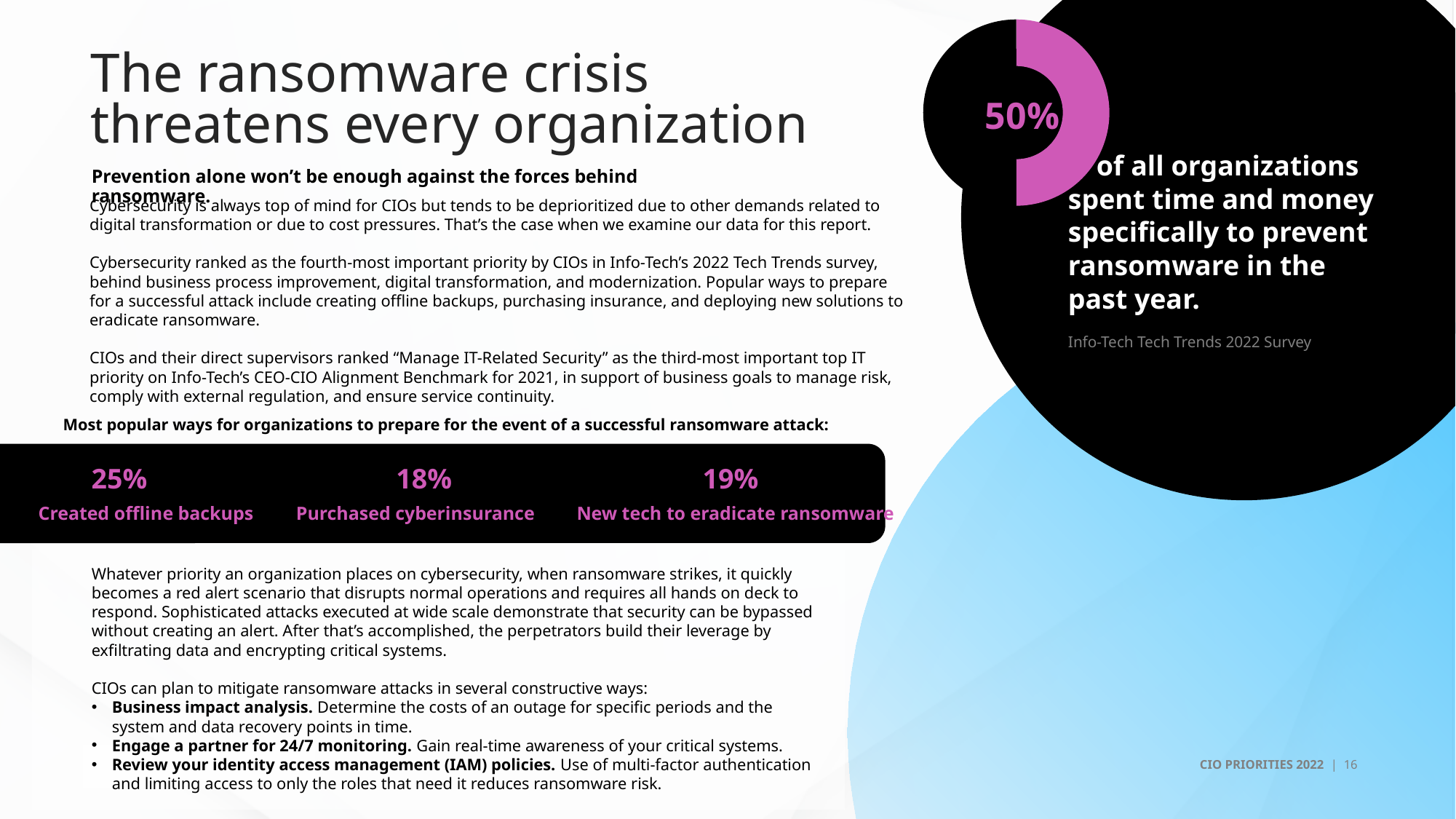
In the strip of statistics on ways to prepare for a ransomware attack, which preparation method has the highest percentage? Created offline backups In the strip of statistics on the most popular ways to prepare for a ransomware attack, what percentage adopted new tech to eradicate ransomware? 19% In the strip of statistics on the most popular ways to prepare for a ransomware attack, what percentage created offline backups? 25% In the strip of statistics on ways to prepare for a ransomware attack, which preparation method has the lowest percentage? Purchased cyberinsurance Is the value shown in the donut chart greater or less than 40%? greater According to the donut chart, what share of all organizations spent time and money specifically to prevent ransomware in the past year? 50% What kind of chart is shown in the top-right of the slide? Donut chart What is the source cited beneath the donut chart? Info-Tech Tech Trends 2022 Survey In the strip of statistics on the most popular ways to prepare for a ransomware attack, what percentage purchased cyberinsurance? 18% In the strip of statistics on ways to prepare for a ransomware attack, what is the difference between the percentage that created offline backups and the percentage that purchased cyberinsurance? 7% What colour is the filled segment of the donut chart? Pink What percentage does the donut chart highlight? 50%